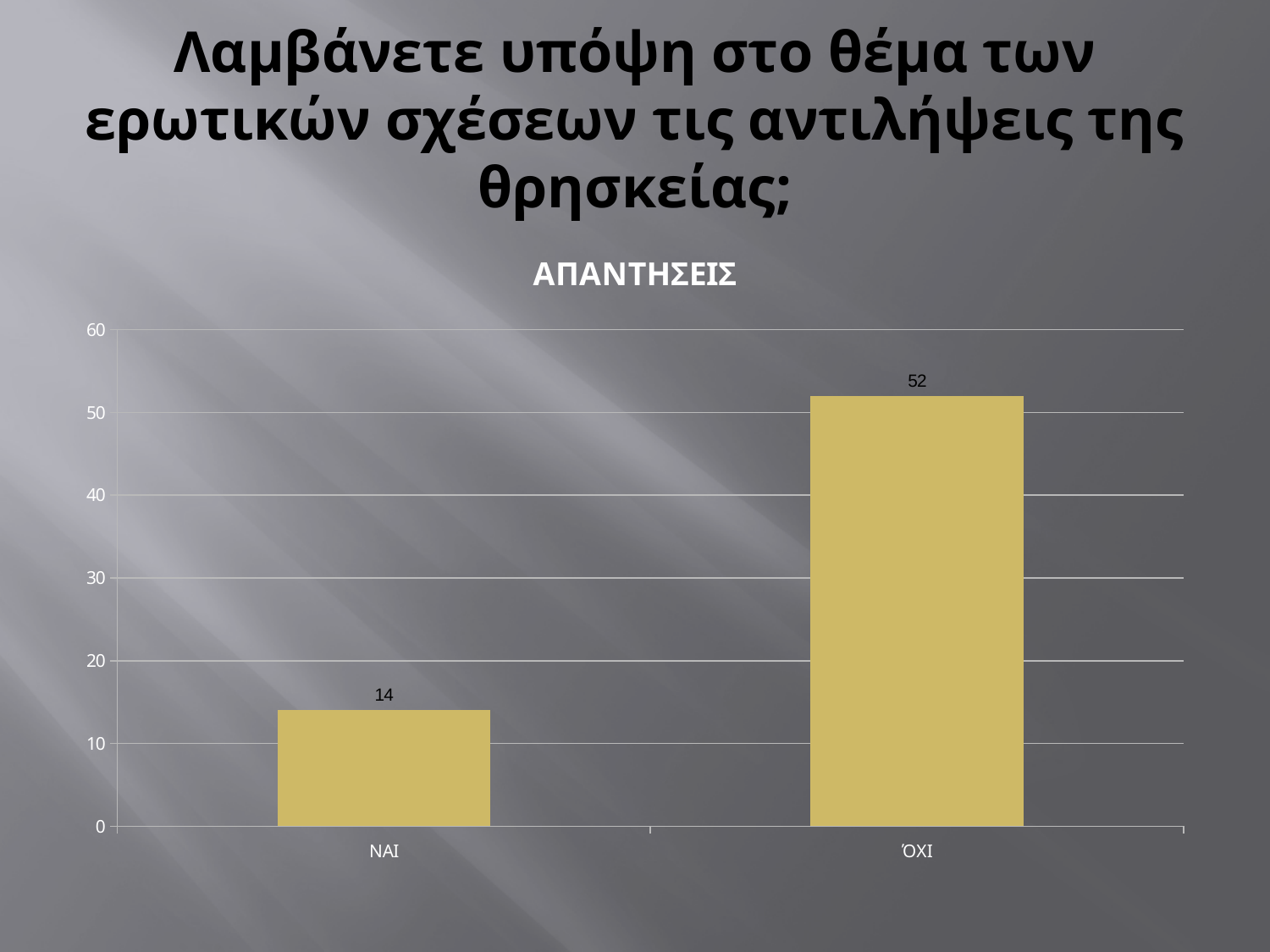
Is the value for ΝΑΙ greater or less than 20? less Is the value for ΌΧΙ greater or less than 50? greater What is the total of the values for ΝΑΙ and ΌΧΙ? 66 What is the value for ΝΑΙ? 14 Which category has the lowest value? ΝΑΙ What kind of chart is shown on the slide? bar chart Which category has the highest value? ΌΧΙ What is the value for ΌΧΙ? 52 How many categories are shown on the x axis? 2 What is the title of the chart? ΑΠΑΝΤΗΣΕΙΣ Which is larger, the value for ΝΑΙ or the value for ΌΧΙ? ΌΧΙ What is the difference between the values for ΌΧΙ and ΝΑΙ? 38